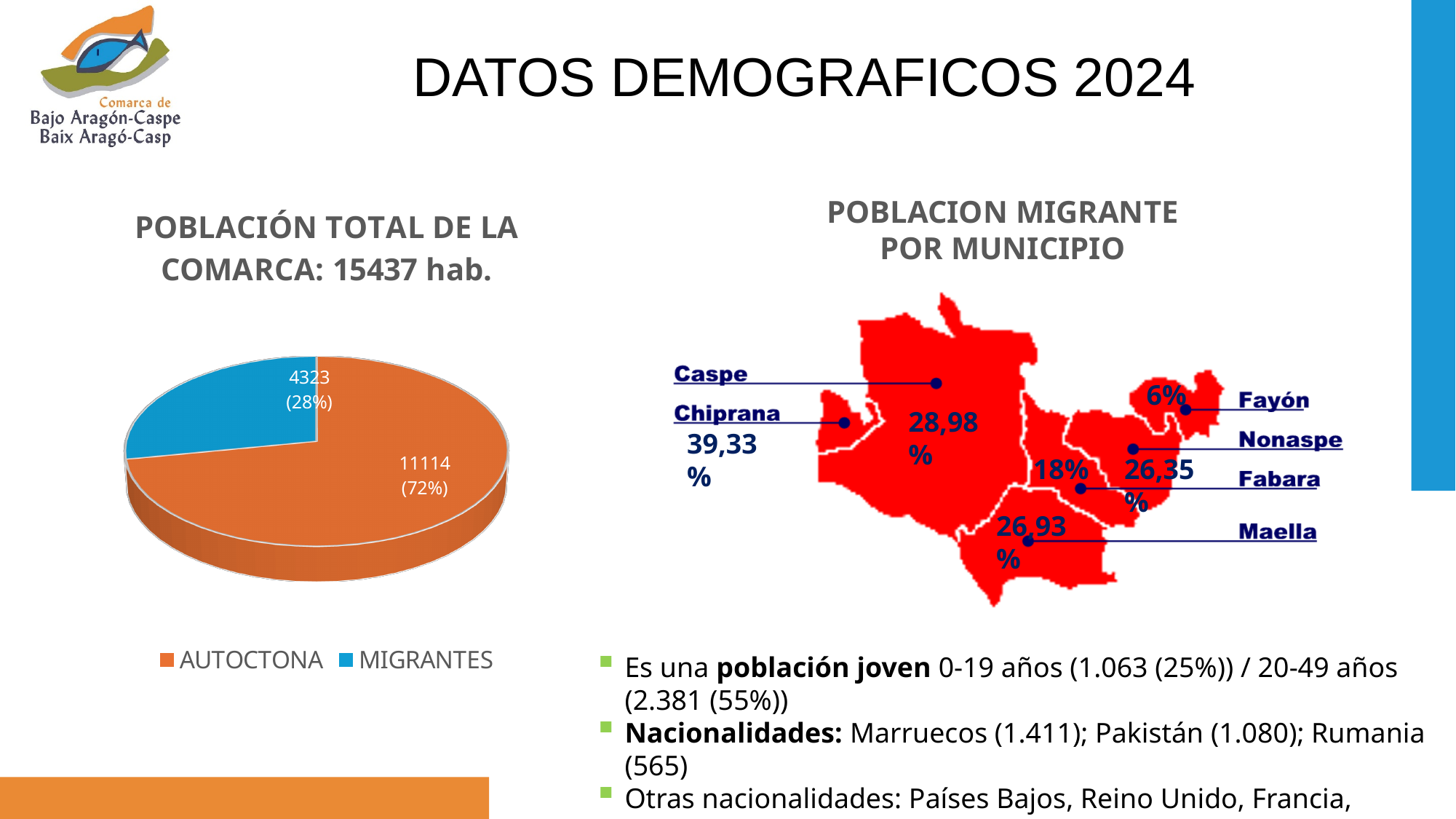
In the pie chart, what is the value for AUTOCTONA? 11114 What total population is stated in the title above the pie chart? 15437 hab. How many categories does the pie chart legend list? 2 In the pie chart, what is the value for MIGRANTES? 4323 In the pie chart, which is larger, AUTOCTONA or MIGRANTES? AUTOCTONA In the pie chart, which category has the smallest slice? MIGRANTES What colour is the MIGRANTES slice in the pie chart? blue What type of chart is used to show the total population of the comarca? pie chart In the pie chart, what percentage share does the AUTOCTONA slice represent? 72% In the pie chart, what is the difference between the AUTOCTONA and MIGRANTES values? 6791 In the pie chart, which category has the largest slice? AUTOCTONA In the pie chart, what percentage share does the MIGRANTES slice represent? 28%